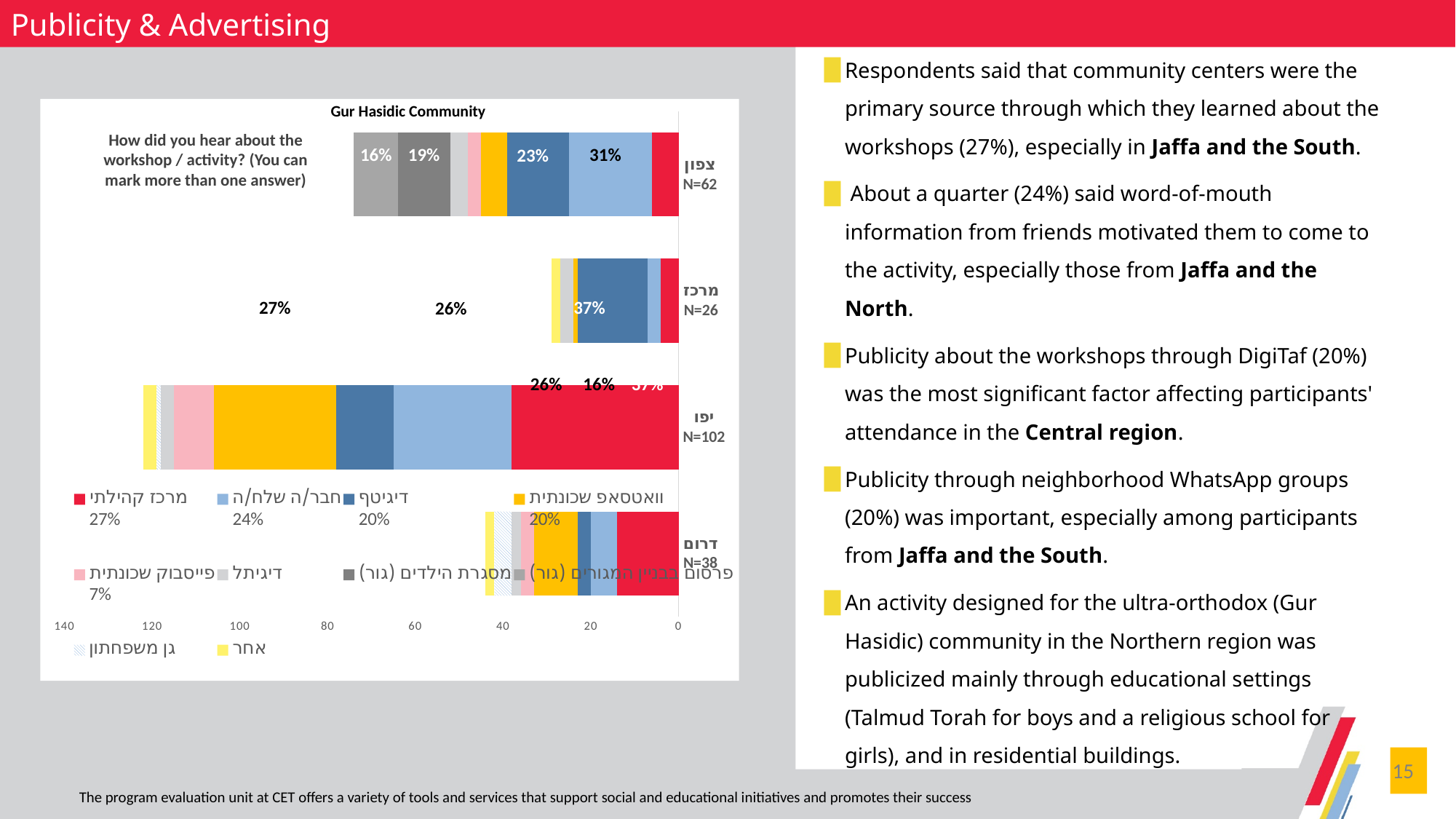
What is the N value shown for the יפו (Jaffa) bar? N=102 What percentage is labelled on the דיגיטף (dark blue) segment of the מרכז (Center) bar? 37% What kind of chart is shown on the slide? Stacked bar chart Is the total length of the יפו (Jaffa) bar greater or less than 100? greater What is the N value shown for the מרכז (Center) bar? N=26 Which region has the shortest stacked bar? מרכז (Center) What percentage is shown next to מרכז קהילתי in the legend? 27% What is the N value shown for the צפון (North) bar? N=62 Which region has the longest stacked bar? יפו (Jaffa) How many regions (bars) are plotted in the chart? 4 How many entries does the chart legend list? 10 Is the total length of the מרכז (Center) bar greater or less than 40? less